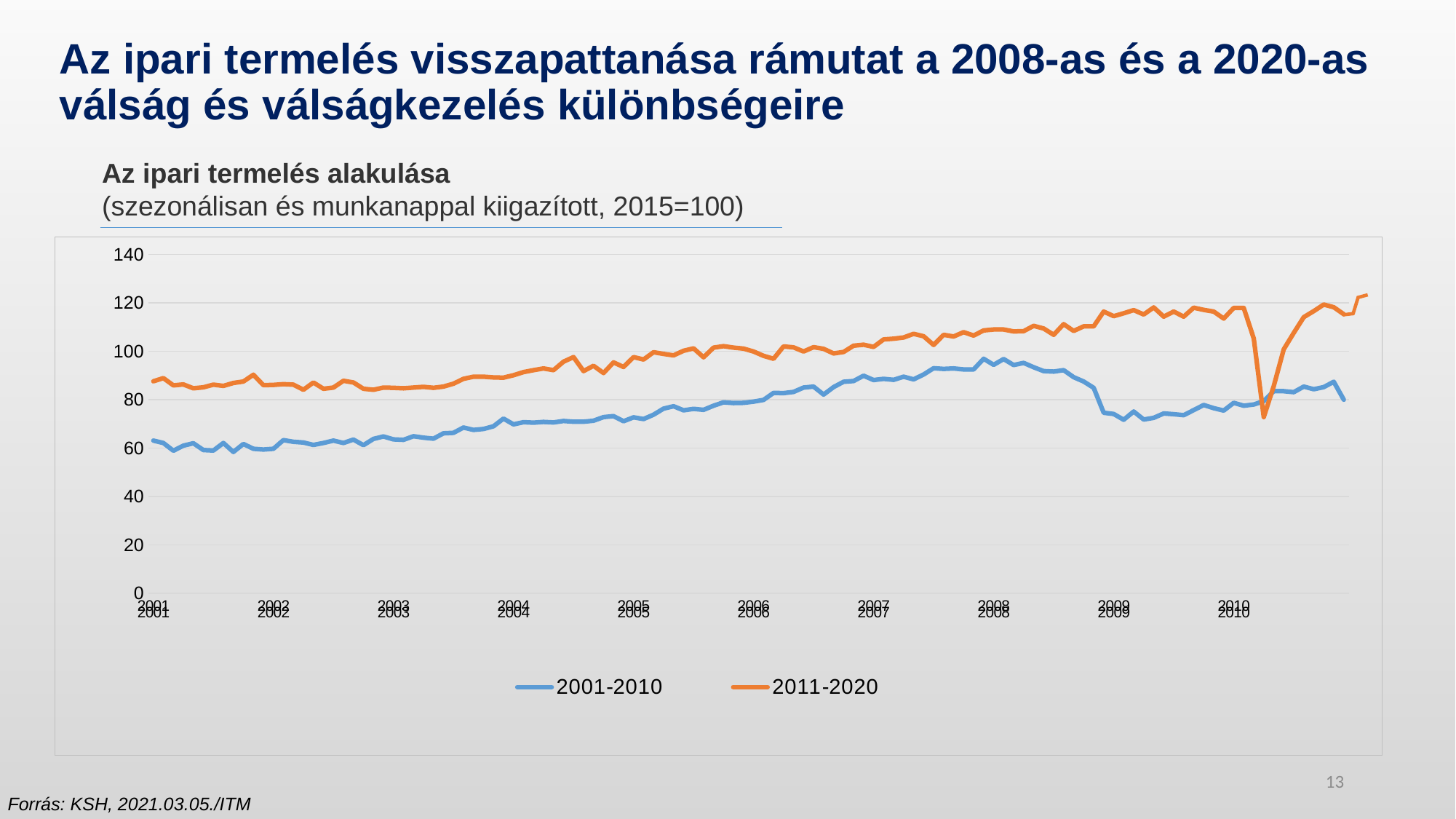
Is the lowest point of the 2011-2020 series (the sharp dip near 2010) greater or less than 80? less Which series reaches the highest value on the chart? 2011-2020 Which colour is used for the 2011-2020 series? orange At the start of the period, which series has the higher value, 2001-2010 or 2011-2020? 2011-2020 Does the 2001-2010 series rise or fall between the 2001 and 2008 positions? rise How many series does the legend list? 2 Is the value of the 2011-2020 series at the start of the period (2001 position) greater or less than 80? greater Is the peak of the 2001-2010 series around 2008 greater or less than 100? less What are the two series named in the legend? 2001-2010 and 2011-2020 What kind of chart is shown on the slide? line chart